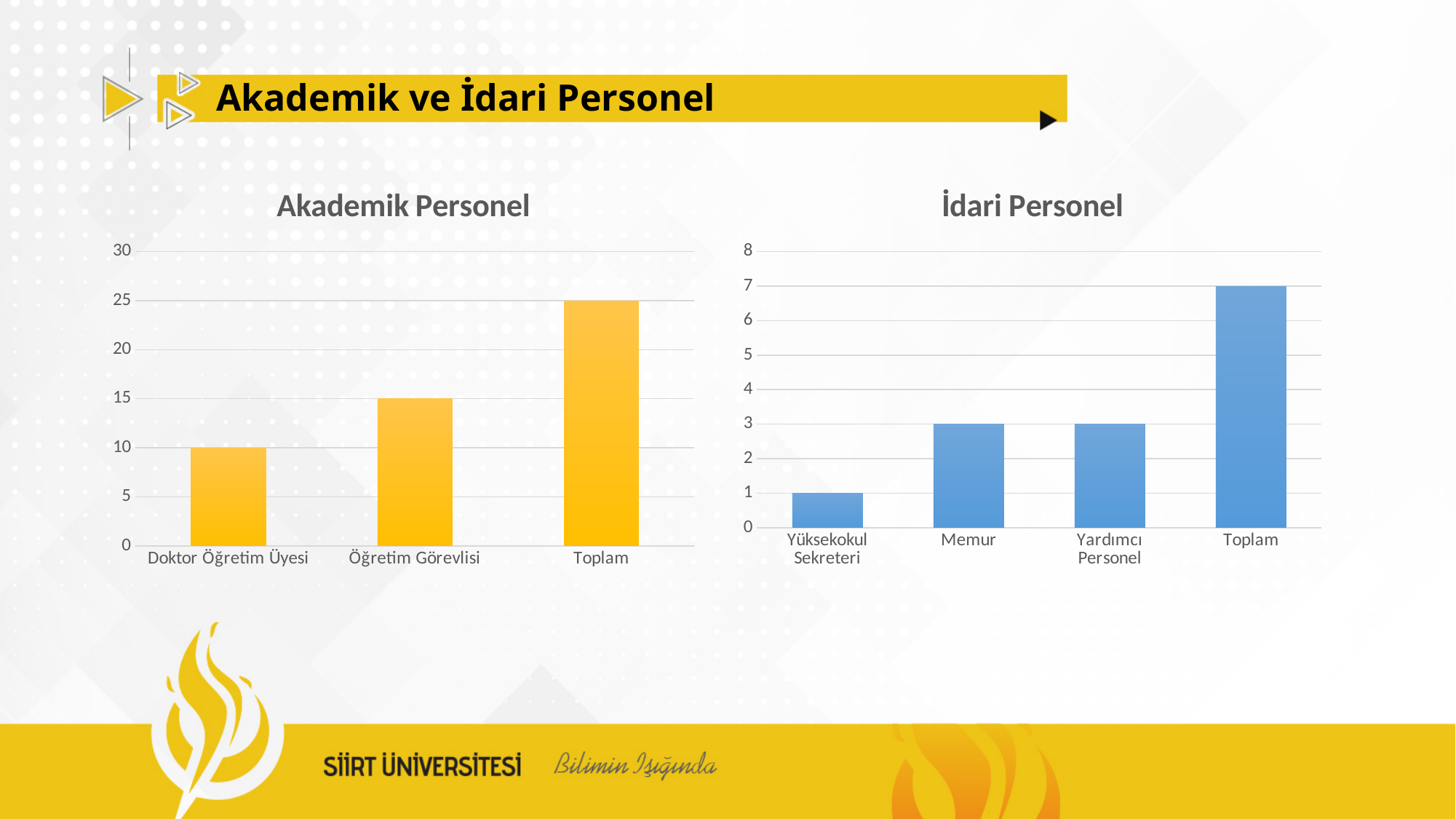
In the İdari Personel chart, what is the value for Memur? 3 What type of chart is the İdari Personel chart? Bar chart In the İdari Personel chart, which is larger, Memur or Yüksekokul Sekreteri? Memur In the İdari Personel chart, how many categories are shown on the x axis? 4 In the İdari Personel chart, what is the value for Yüksekokul Sekreteri? 1 In the Akademik Personel chart, what is the value for Toplam? 25 In the Akademik Personel chart, how many categories are shown on the x axis? 3 In the İdari Personel chart, which category has the lowest value? Yüksekokul Sekreteri In the Akademik Personel chart, what is the value for Doktor Öğretim Üyesi? 10 In the İdari Personel chart, what is the value for Toplam? 7 In the Akademik Personel chart, what is the value for Öğretim Görevlisi? 15 In the Akademik Personel chart, what is the difference between Öğretim Görevlisi and Doktor Öğretim Üyesi? 5